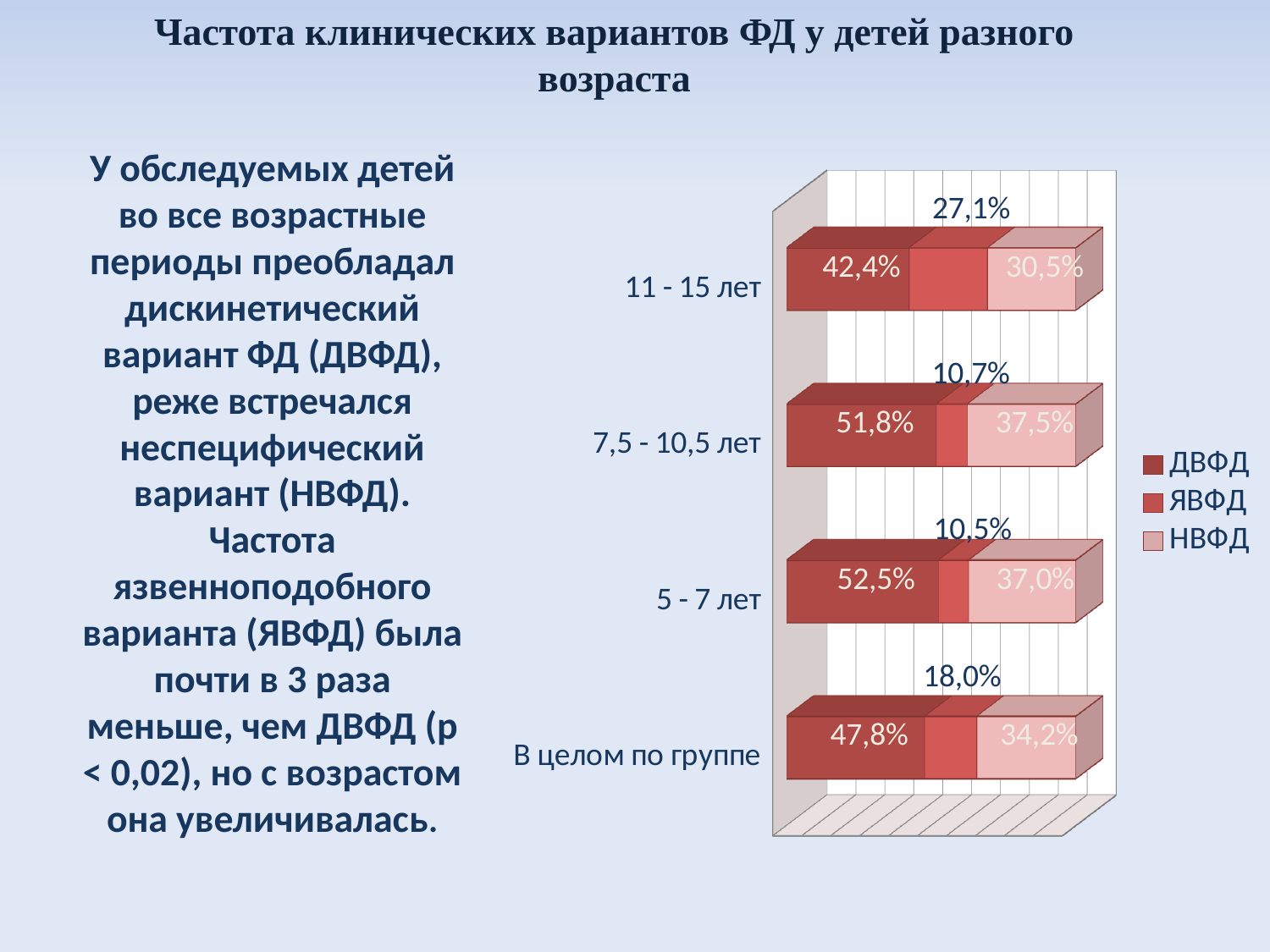
In which category is the ДВФД value highest? 5 - 7 лет In which category is the ЯВФД value highest? 11 - 15 лет What is the difference between the ДВФД and НВФД values in the 11 - 15 лет category? 11,9% What is the value for ЯВФД in the 5 - 7 лет category? 10,5% How many series does the legend list? 3 How many age categories are shown on the chart? 3 What is the value for ДВФД in the 11 - 15 лет category? 42,4% What is the value for НВФД in the В целом по группе category? 34,2% In which category is the ДВФД value lowest? 11 - 15 лет Which is larger in the 5 - 7 лет category: ДВФД or НВФД? ДВФД What kind of chart is shown on the slide? Stacked bar chart What is the value for ЯВФД in the 7,5 - 10,5 лет category? 10,7%